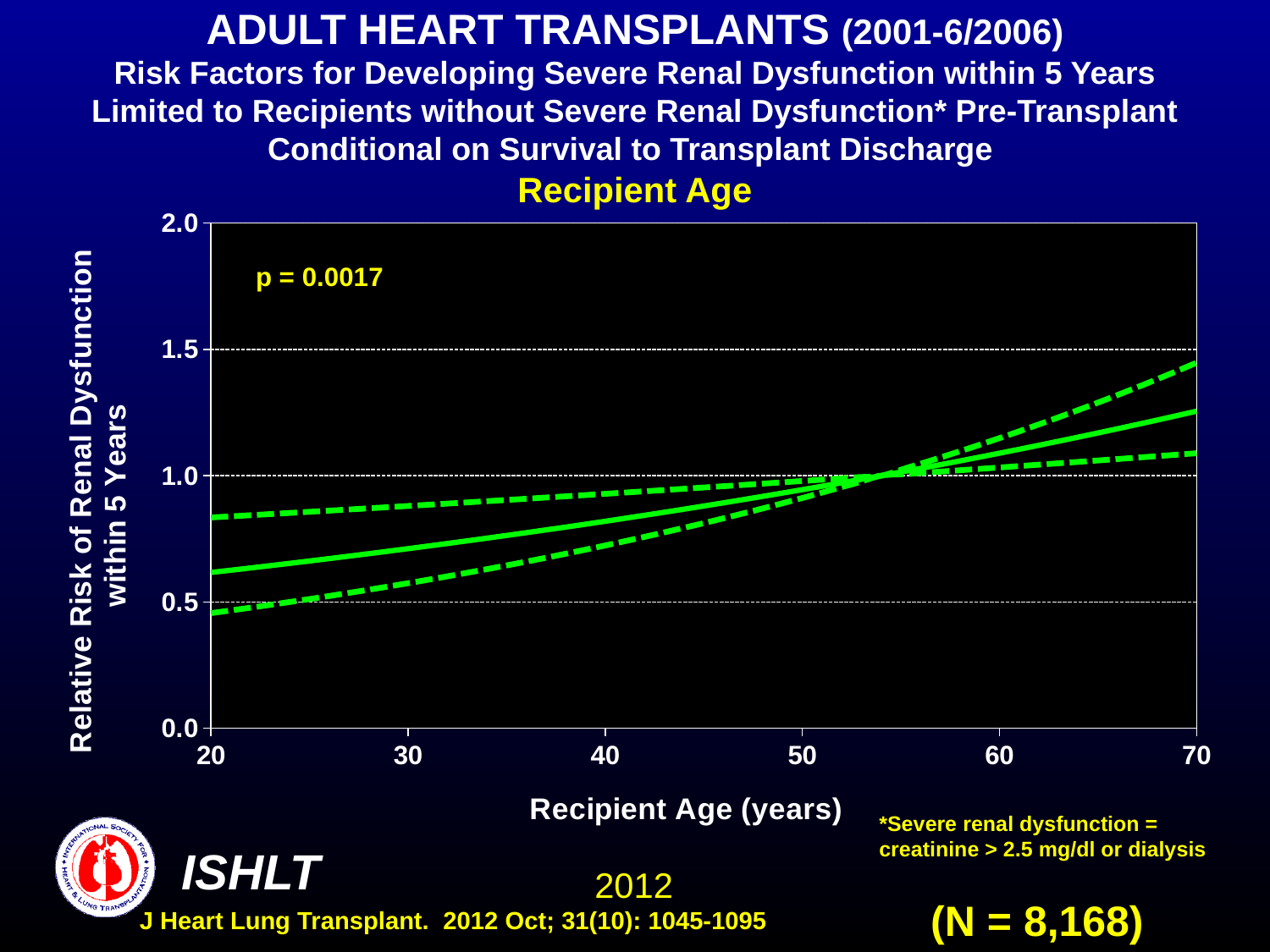
Is the upper dashed line at recipient age 20 greater or less than 1.0? less What p-value is printed on the chart? p = 0.0017 How many lines are plotted on the chart? 3 What is the N reported on the slide? N = 8,168 Is the relative risk shown by the solid line at recipient age 70 greater or less than 1.0? greater Is the upper dashed line at recipient age 70 greater or less than 1.5? less Does the relative risk of renal dysfunction rise or fall as recipient age increases from 20 to 70 years? rise How many tick marks are labelled on the Recipient Age (years) axis? 6 Is the relative risk shown by the solid line higher at recipient age 70 or at recipient age 20? age 70 What kind of chart is shown on the slide? line chart